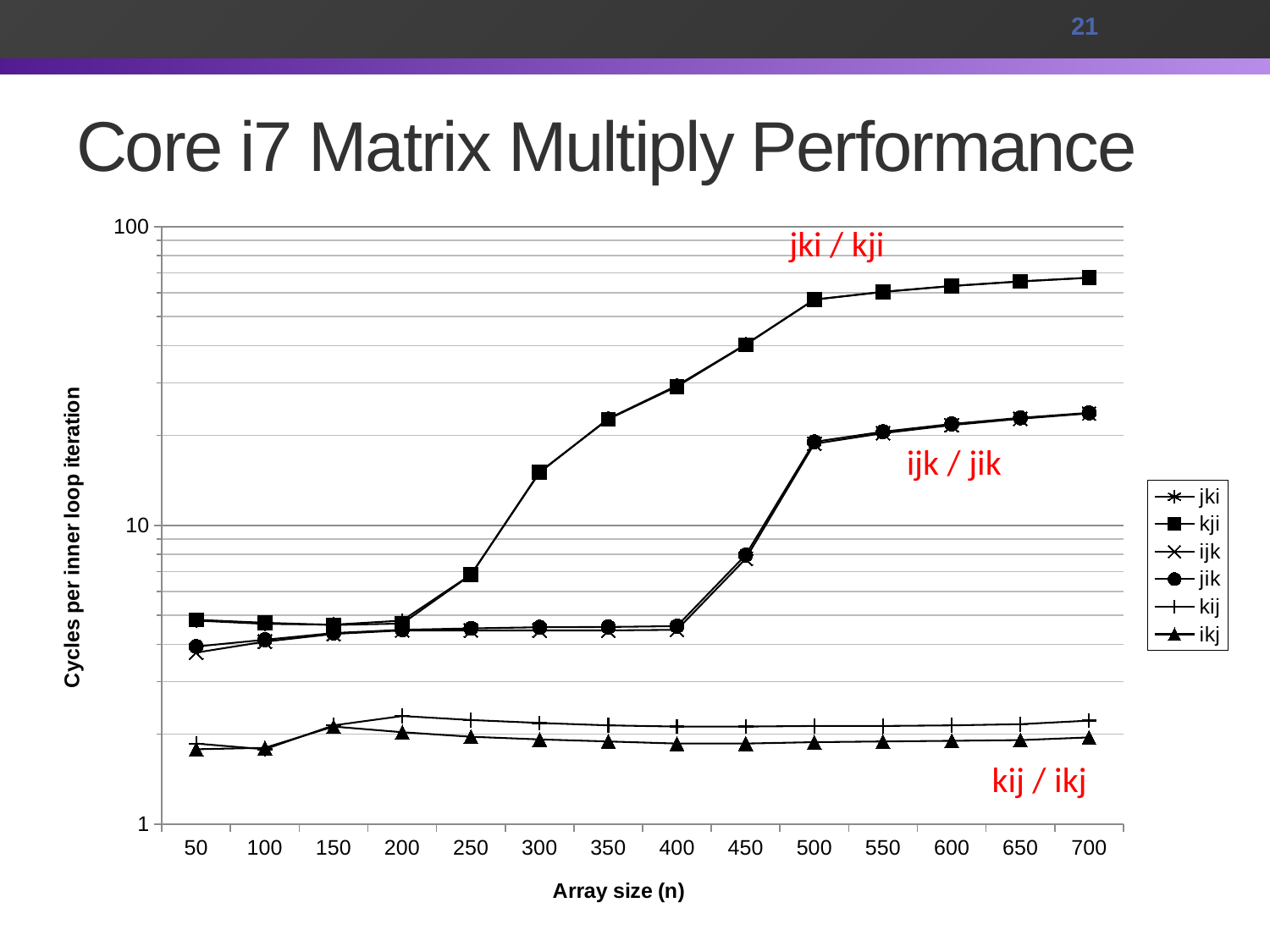
Is the value for jik at array size 300 greater or less than 10? less Is the value for kji at array size 700 greater or less than 10? greater Is the value for kji at array size 300 greater or less than 10? greater Does the value for kji rise or fall as the array size increases from 200 to 500? rise Which pair of series has the lowest values across the chart? kij / ikj Which pair of series has the highest values at array size 700? jki / kji Which is larger at array size 500, the value for kji or the value for jik? kji What is the label of the y axis? Cycles per inner loop iteration What kind of chart is shown on the slide? line chart How many array sizes are marked along the x axis? 14 How many series does the legend list? 6